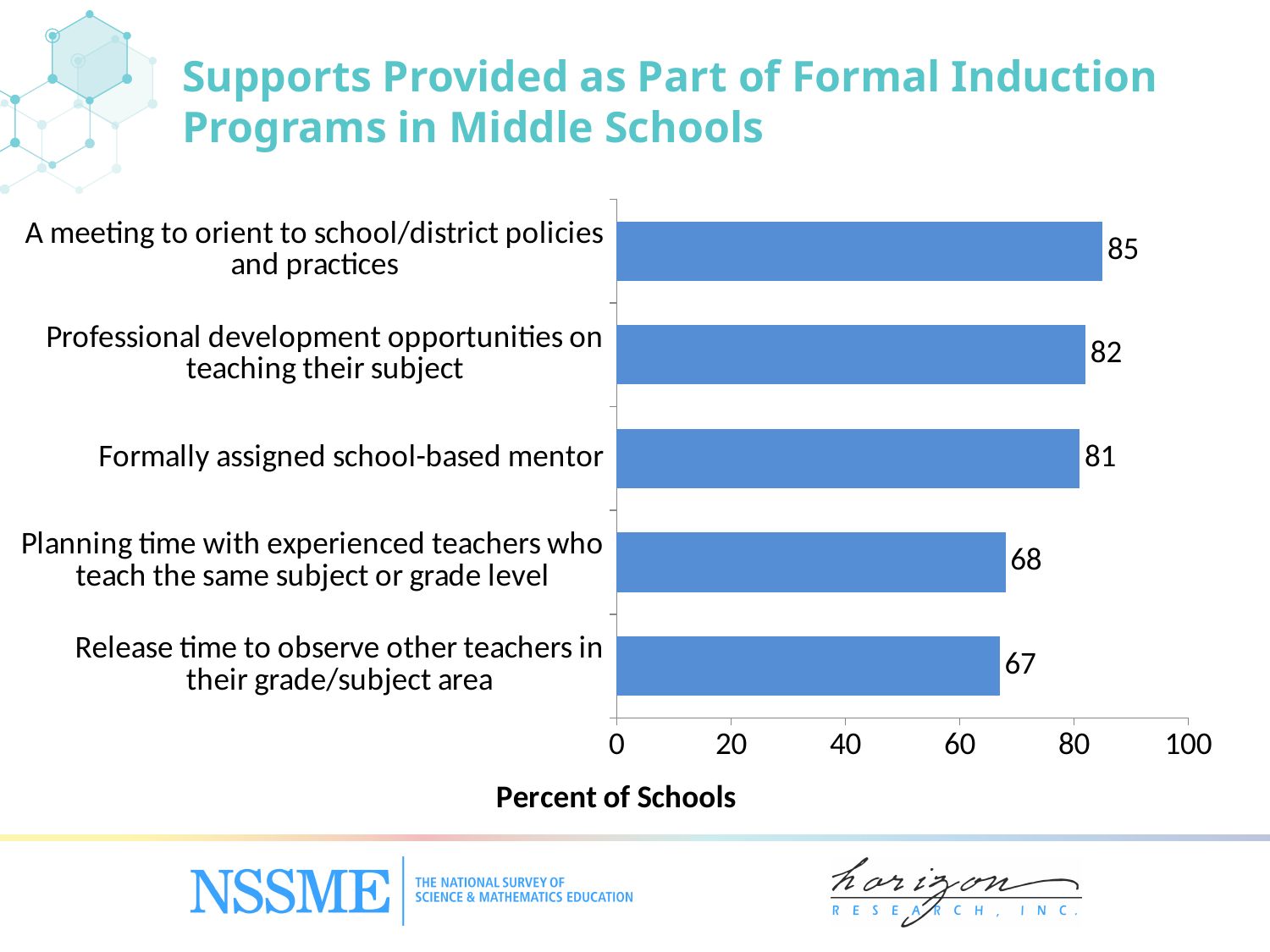
What percent of schools provide a meeting to orient to school/district policies and practices? 85 What is the value for 'Formally assigned school-based mentor'? 81 Which is larger: the value for 'Formally assigned school-based mentor' or the value for 'Planning time with experienced teachers who teach the same subject or grade level'? Formally assigned school-based mentor What is the title of the chart? Supports Provided as Part of Formal Induction Programs in Middle Schools What is the difference between the values for 'Professional development opportunities on teaching their subject' and 'Planning time with experienced teachers who teach the same subject or grade level'? 14 What is the label of the horizontal axis? Percent of Schools Is the value for 'Planning time with experienced teachers who teach the same subject or grade level' greater or less than 80? less What kind of chart is shown on the slide? Bar chart Which support has the lowest percent of schools? Release time to observe other teachers in their grade/subject area What percent of schools provide release time to observe other teachers in their grade/subject area? 67 How many supports are shown in the chart? 5 Which support has the highest percent of schools? A meeting to orient to school/district policies and practices